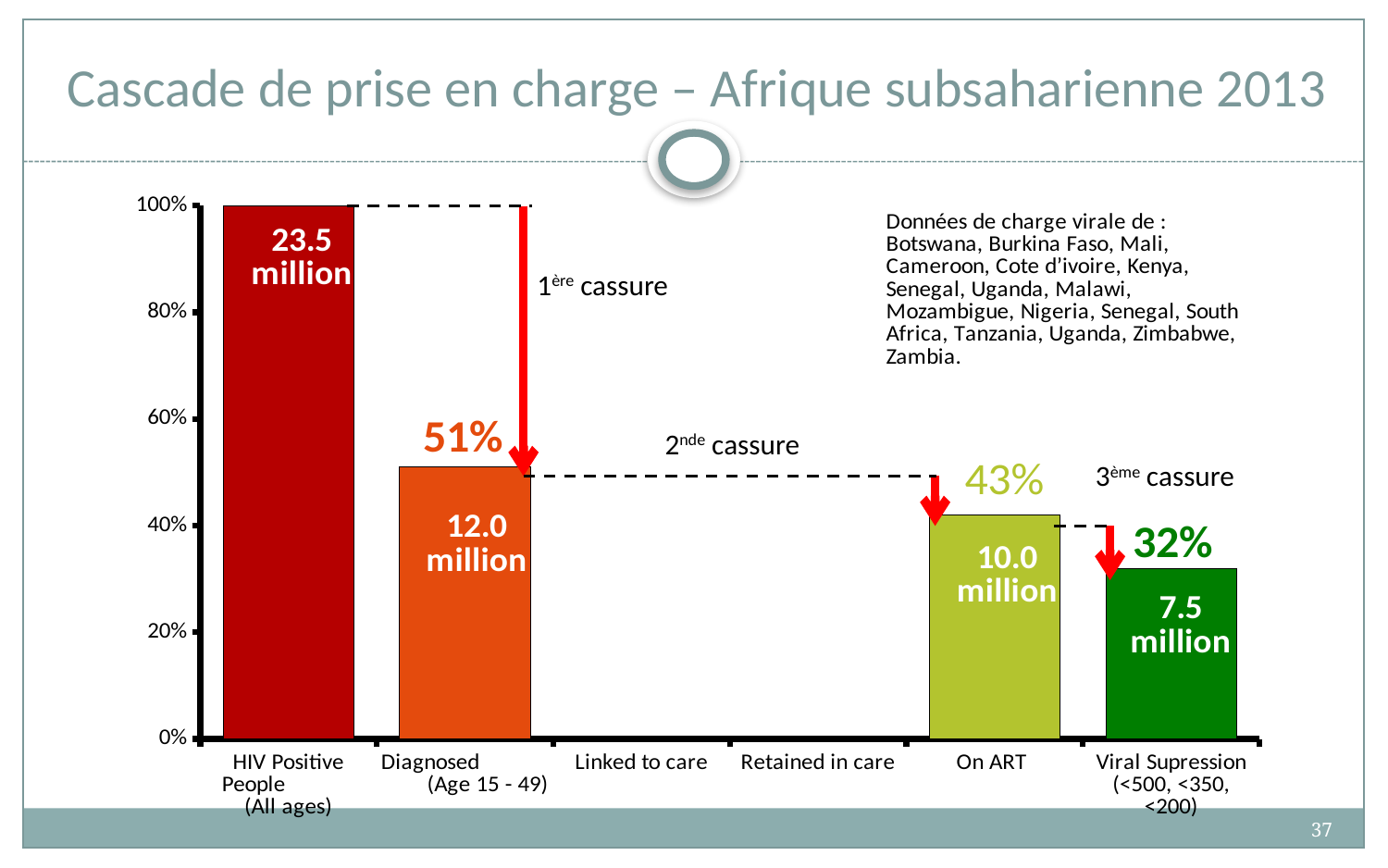
Do the bar values rise or fall from left to right along the x axis? fall How many category labels are shown along the x axis? 6 What is the difference in percentage points between the Diagnosed bar (51%) and the On ART bar (43%)? 8 What is the number of people shown on the bar for HIV Positive People (All ages)? 23.5 million What percentage is labelled for Viral Supression? 32% What percentage is labelled above the Diagnosed (Age 15 - 49) bar? 51% Which is larger, the value for On ART or the value for Viral Supression? On ART What kind of chart is shown on the slide? bar chart Is the value for Diagnosed (Age 15 - 49) greater or less than 40%? greater What is the number of people shown on the On ART bar? 10.0 million Among the categories with a bar, which has the lowest value? Viral Supression Which category has the tallest bar? HIV Positive People (All ages)